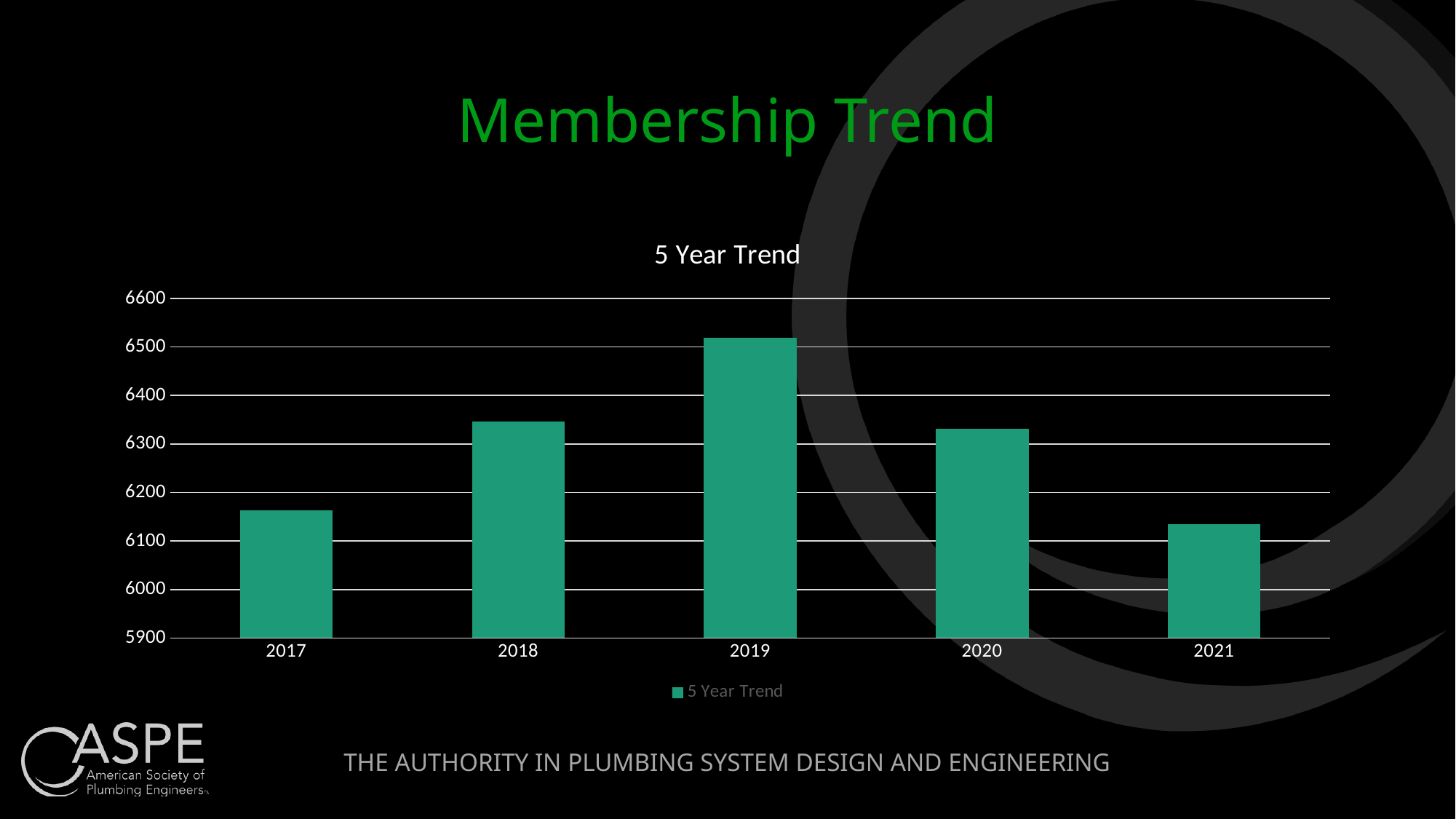
Which year has the highest membership value in the chart? 2019 What kind of chart is shown on the slide? bar chart Is the value for 2021 greater or less than 6200? less Is the value for 2019 greater or less than 6400? greater Is the value for 2018 greater or less than 6300? greater What is the title shown above the chart's plot area? 5 Year Trend Which is larger, the value for 2019 or the value for 2021? 2019 How many years are shown on the x axis of the chart? 5 How many series does the chart legend list? 1